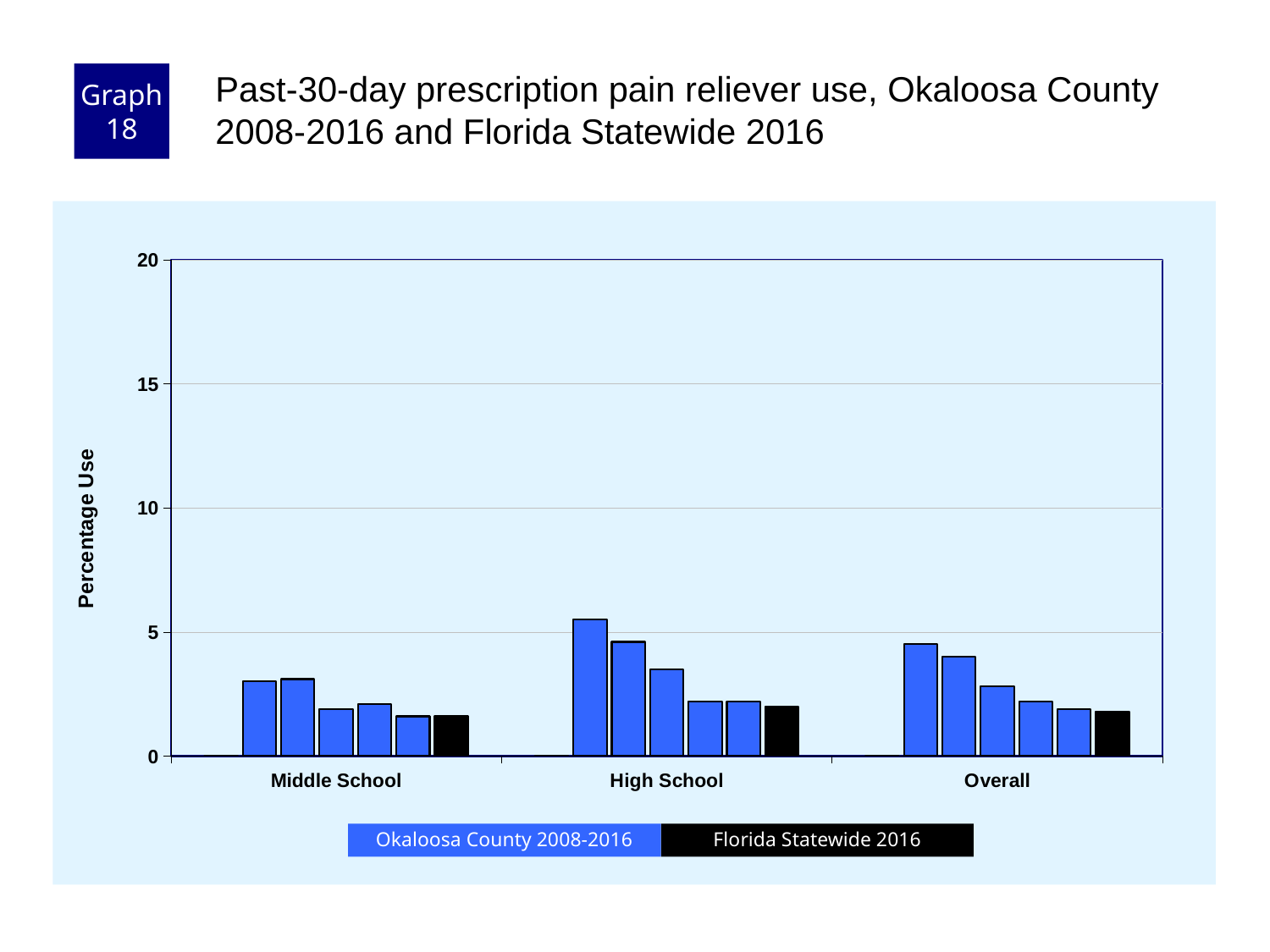
Is the tallest bar for Overall greater or less than 10? less Is the Florida Statewide 2016 value for High School greater or less than 5? less How many series does the legend list? 2 Which category contains the tallest bar in the chart? High School Is the Florida Statewide 2016 value for Overall greater or less than 5? less What kind of chart is shown on the slide? bar chart Which series is shown in black in the legend? Florida Statewide 2016 How many categories are shown on the x axis? 3 What is the label of the y axis? Percentage Use Which is larger: the tallest bar for High School or the tallest bar for Middle School? High School